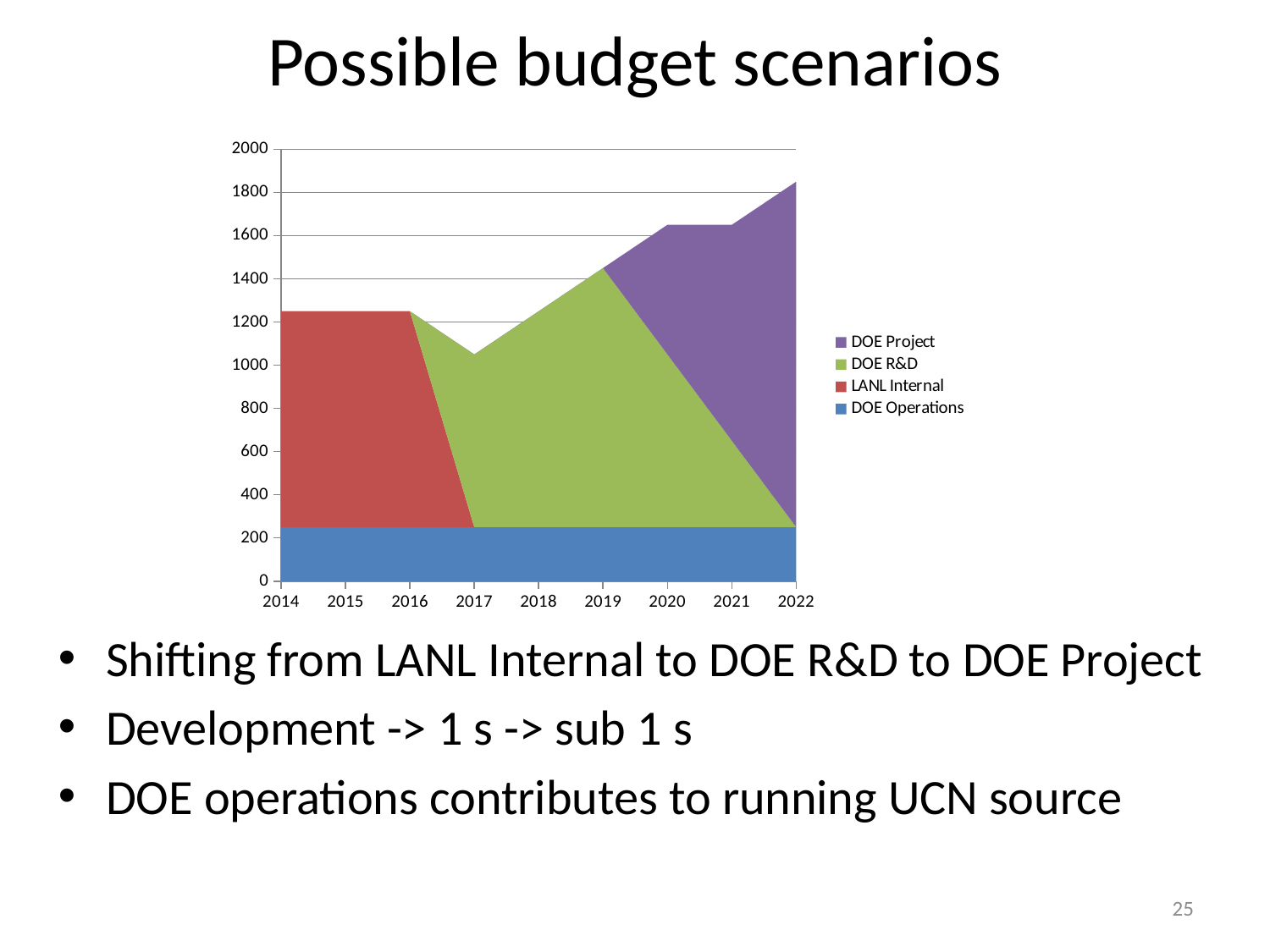
Is the total budget for 2022 greater or less than 1800? greater Which year has a larger total budget, 2014 or 2017? 2014 Is the total budget for 2017 greater or less than 1200? less What kind of chart is shown on the slide? Stacked area chart Is the DOE Operations value in 2018 greater or less than 400? less Which year has the lowest total budget in the chart? 2017 How many years are shown along the x axis of the chart? 9 Which series is shown at the bottom of the stacked areas in the chart? DOE Operations Does the total budget rise or fall from 2017 to 2022? rise How many series does the chart legend list? 4 Which year has the highest total budget in the chart? 2022